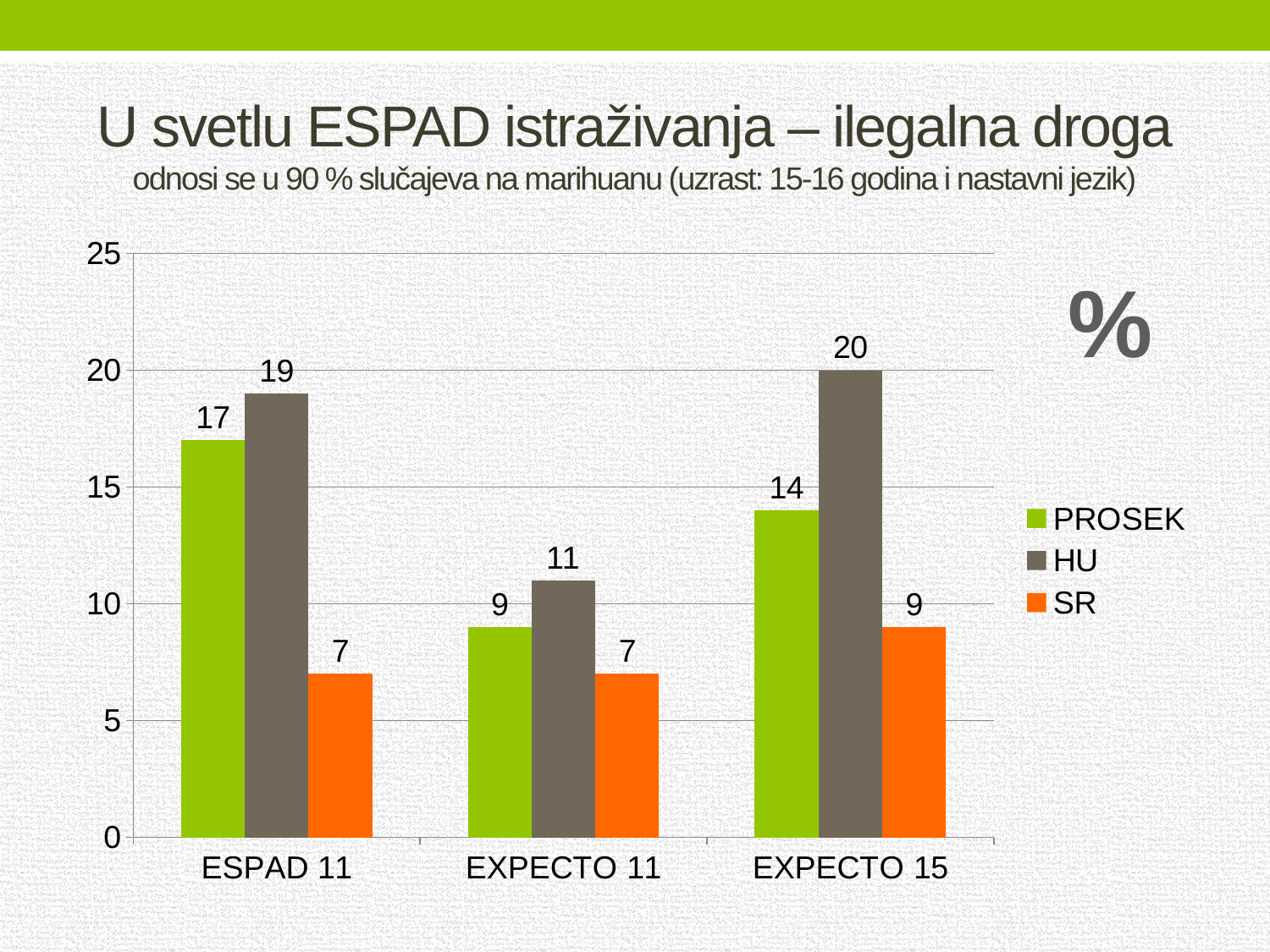
Does the HU value rise or fall from EXPECTO 11 to EXPECTO 15? rise Which category has the lowest PROSEK value? EXPECTO 11 Which series is shown in orange in the legend? SR How many series does the legend list? 3 What is the value for SR in the EXPECTO 11 category? 7 What is the value for HU in the ESPAD 11 category? 19 What kind of chart is shown on the slide? bar chart Which is larger in the ESPAD 11 category, PROSEK or HU? HU Which category has the highest HU value? EXPECTO 15 What is the difference between the HU and SR values in the EXPECTO 15 category? 11 What is the value for PROSEK in the EXPECTO 15 category? 14 How many categories are shown on the x axis? 3